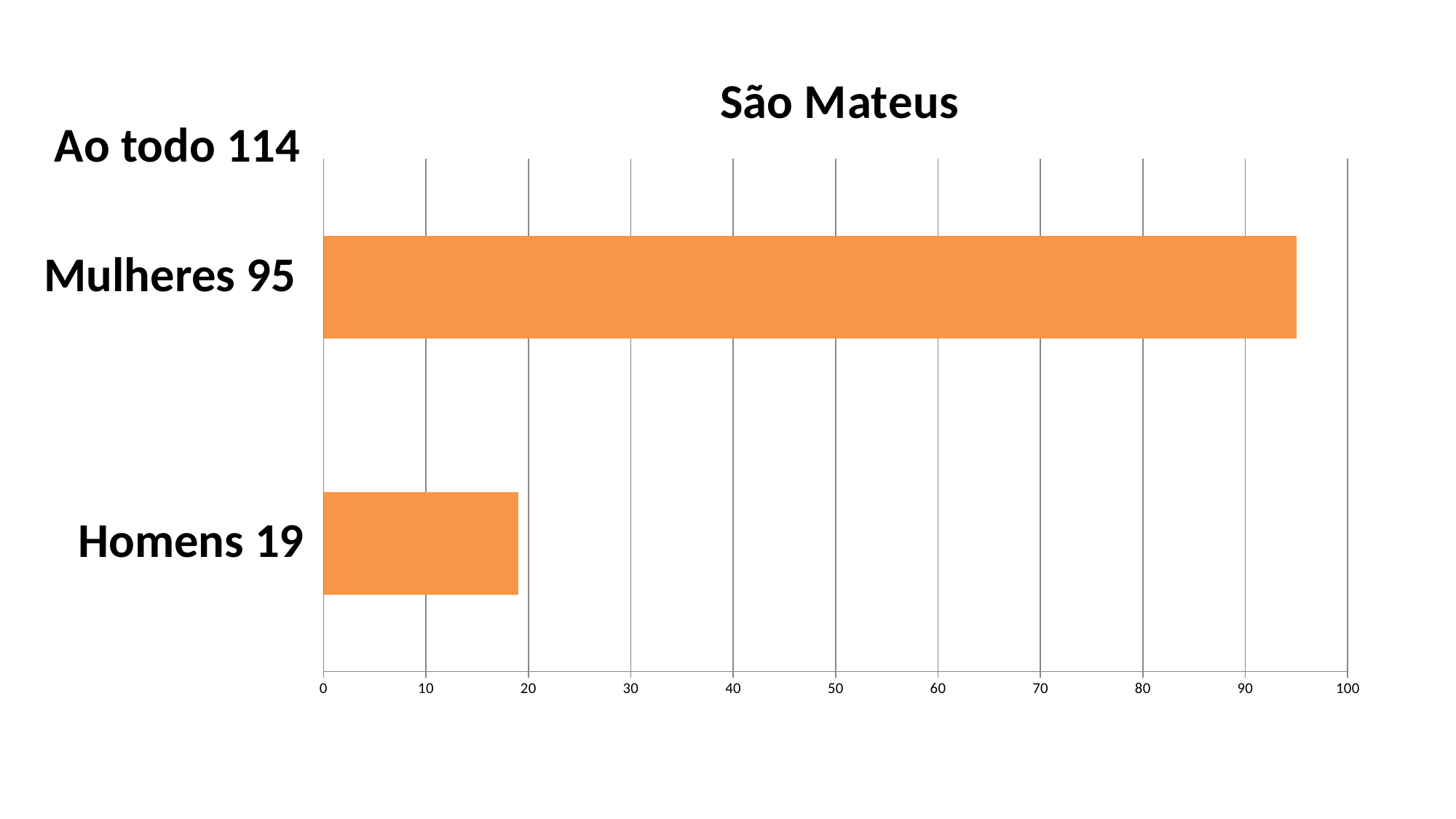
How many bars are plotted in the chart? 2 What total is stated on the slide for all categories combined (Ao todo)? 114 Is the value for Homens greater or less than 20? less What is the value for Homens? 19 What is the value for Mulheres? 95 Which category has the highest value? Mulheres Which category has the lowest value? Homens What kind of chart is shown? bar chart What is the difference between the values for Mulheres and Homens? 76 What is the title of the chart? São Mateus Is the value for Mulheres greater or less than 90? greater Which is larger, the value for Mulheres or the value for Homens? Mulheres